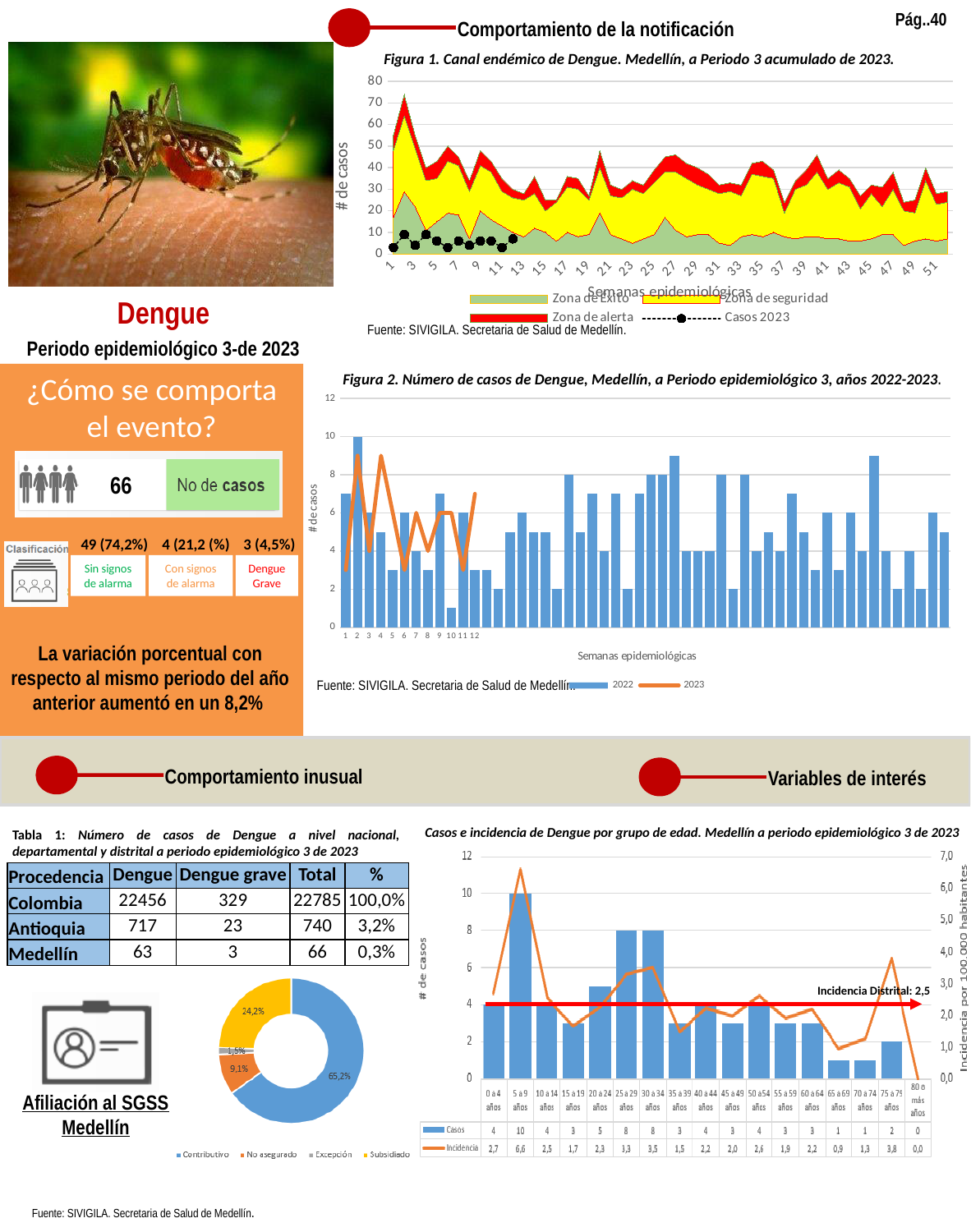
In the chart 'Casos e incidencia de Dengue por grupo de edad', what is the Incidencia for the 5 a 9 años group? 6,6 How many series does the legend of Figura 2 list? 2 In the chart 'Casos e incidencia de Dengue por grupo de edad', what is the difference in Casos between the 5 a 9 años group and the 0 a 4 años group? 6 In the chart 'Casos e incidencia de Dengue por grupo de edad', which is larger: the Incidencia for 75 a 79 años or for 70 a 74 años? 75 a 79 años In the chart 'Casos e incidencia de Dengue por grupo de edad', how many age groups are shown on the x axis? 17 In the donut chart 'Afiliación al SGSS Medellín', which category has the smallest share? Excepción In the donut chart 'Afiliación al SGSS Medellín', what share does Subsidiado have? 24,2% In the chart 'Casos e incidencia de Dengue por grupo de edad', which age group has the highest number of Casos? 5 a 9 años How many categories does the legend of the donut chart 'Afiliación al SGSS Medellín' list? 4 In the chart 'Casos e incidencia de Dengue por grupo de edad', how many Casos are reported for the 5 a 9 años group? 10 In the donut chart 'Afiliación al SGSS Medellín', what percentage is shown for the Contributivo slice? 65,2% In Figura 2, is the 2022 value for week 2 greater or less than 8? greater